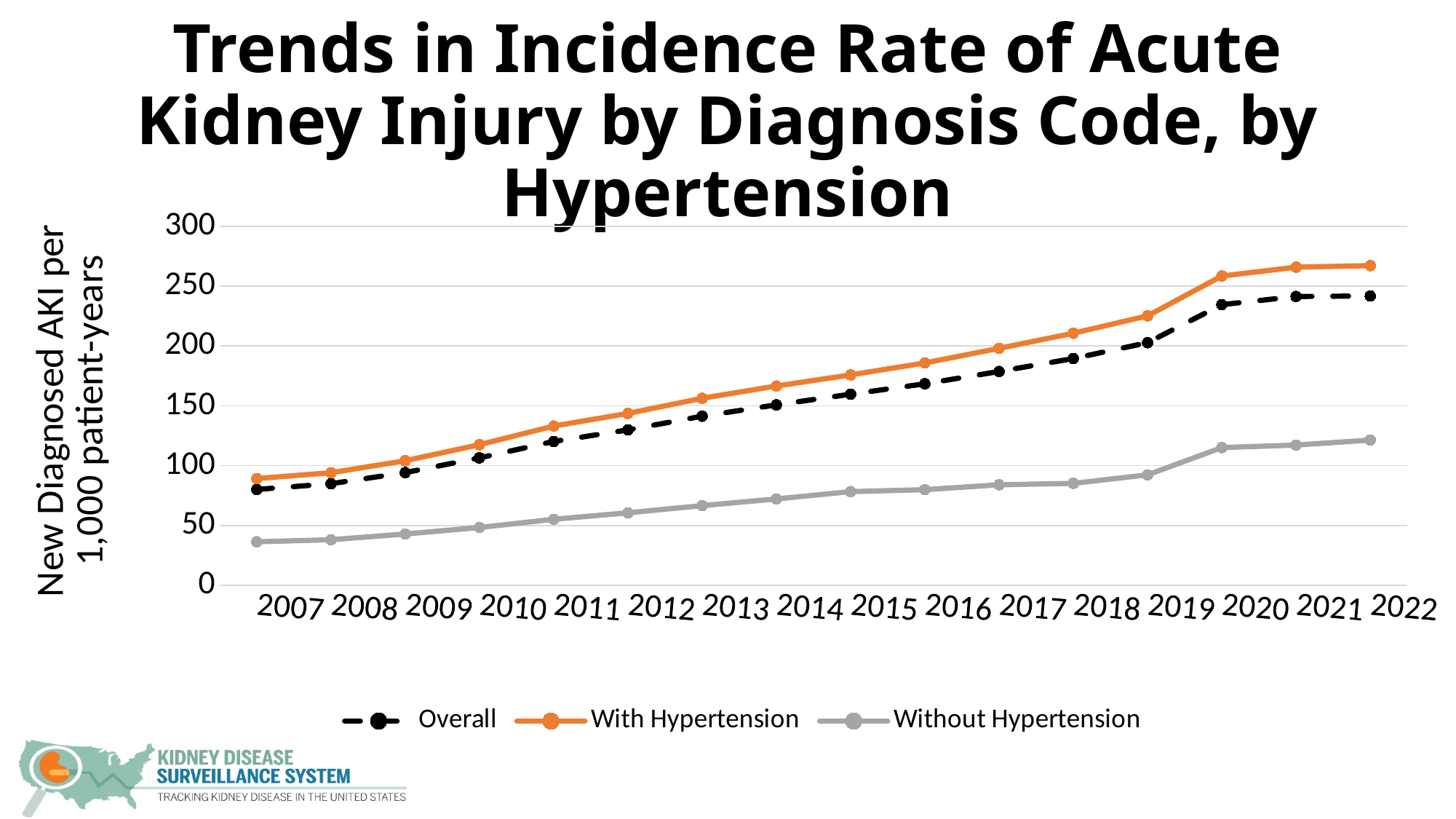
Is the value for Without Hypertension in 2022 greater or less than 100? greater Does the With Hypertension line rise or fall from 2007 to 2022? rise Is the value for With Hypertension in 2022 greater or less than 250? greater Is the value for With Hypertension in 2007 greater or less than 100? less How many series does the legend list? 3 In 2015, which is larger: the value for With Hypertension or for Without Hypertension? With Hypertension What is the label of the y axis? New Diagnosed AKI per 1,000 patient-years What kind of chart is shown on the slide? line chart Which series has the highest value in 2020? With Hypertension How many years are plotted along the x axis? 16